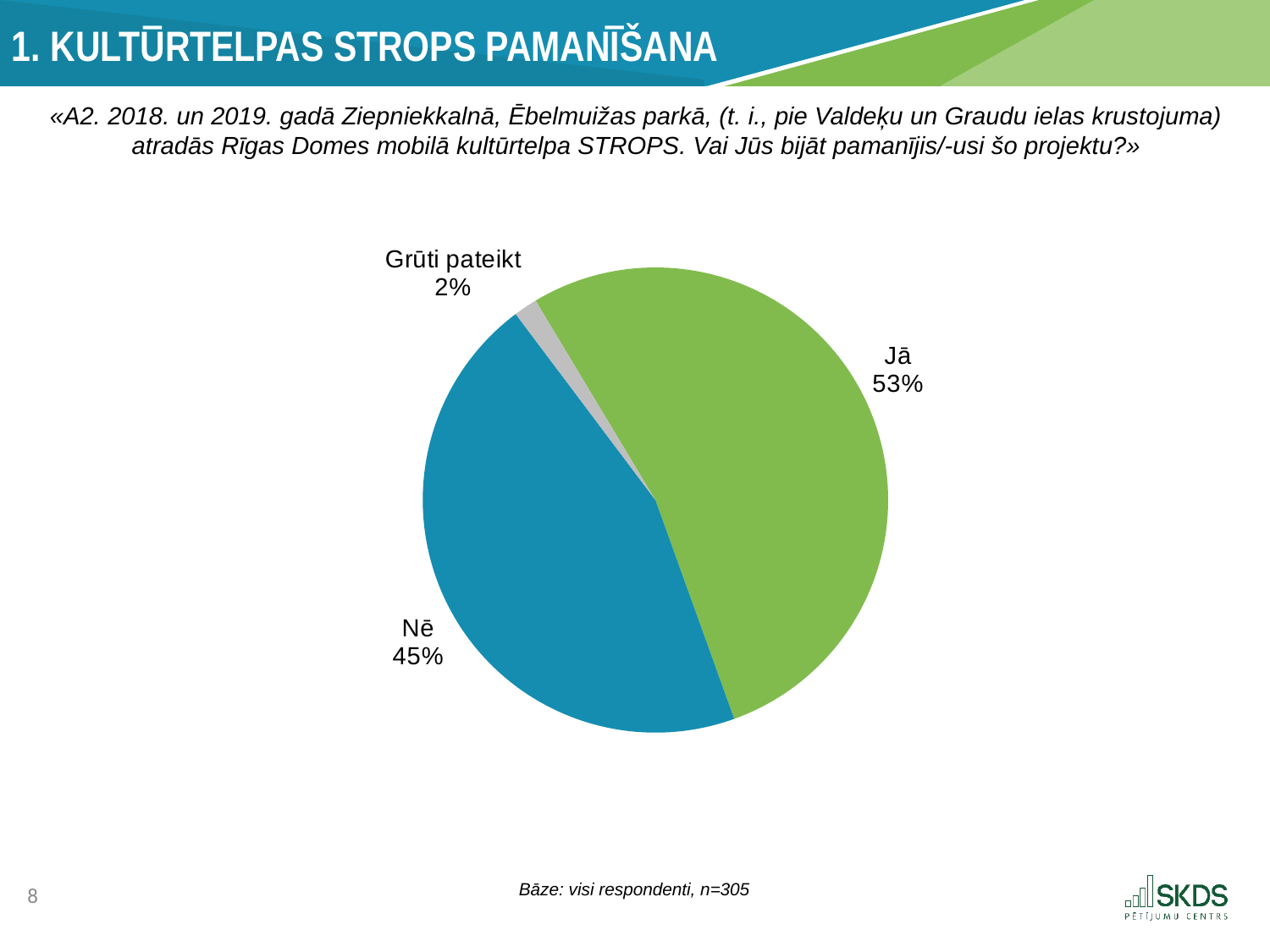
What percentage of respondents answered "Grūti pateikt"? 2% What kind of chart is shown on the slide? pie chart What is the combined share of "Nē" and "Grūti pateikt"? 47% What is the base (number of respondents) stated below the chart? n=305 What is the difference in percentage points between "Jā" and "Nē"? 8 What percentage of respondents answered "Nē"? 45% Which answer has the smallest share of the pie? Grūti pateikt What colour is the "Jā" slice? green Which is larger, the share for "Jā" or the share for "Nē"? Jā How many slices does the pie chart have? 3 Which answer has the largest share of the pie? Jā What percentage of respondents answered "Jā"? 53%